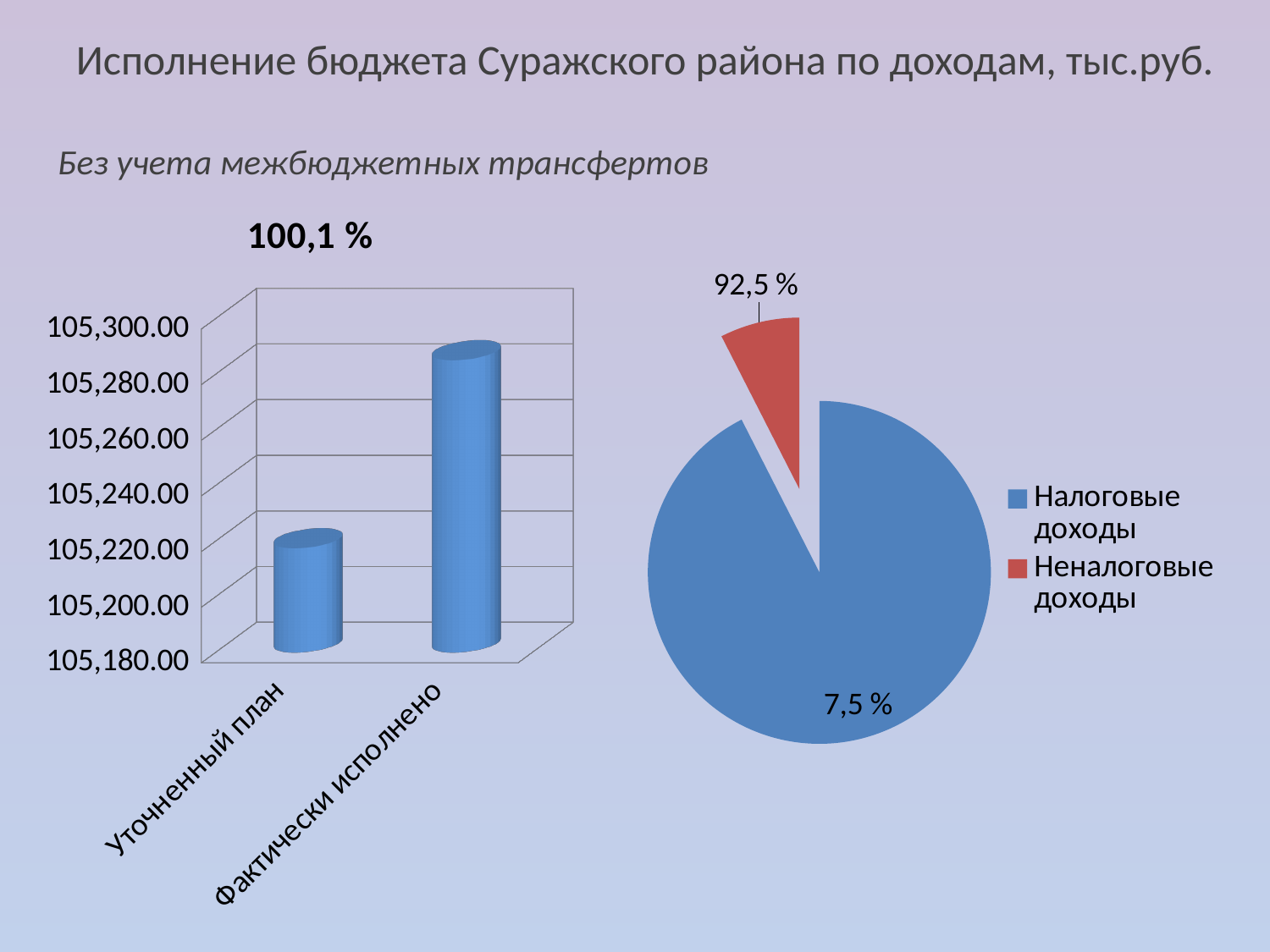
In the right pie chart, what colour is the Неналоговые доходы slice? red In the left bar chart, which category has the higher bar? Фактически исполнено In the left bar chart, is the value for Фактически исполнено greater or less than 105,260.00? greater In the left bar chart, which is larger: Уточненный план or Фактически исполнено? Фактически исполнено In the left bar chart, is the value for Уточненный план greater or less than 105,240.00? less What kind of chart is the left chart on the slide? bar chart In the left bar chart, how many categories are shown on the x axis? 2 In the right pie chart, how many entries does the legend list? 2 In the left bar chart, which category has the lower bar? Уточненный план What percentage is printed above the left bar chart? 100,1 % What kind of chart is the right chart on the slide? pie chart In the right pie chart, which slice is larger: Налоговые доходы or Неналоговые доходы? Налоговые доходы